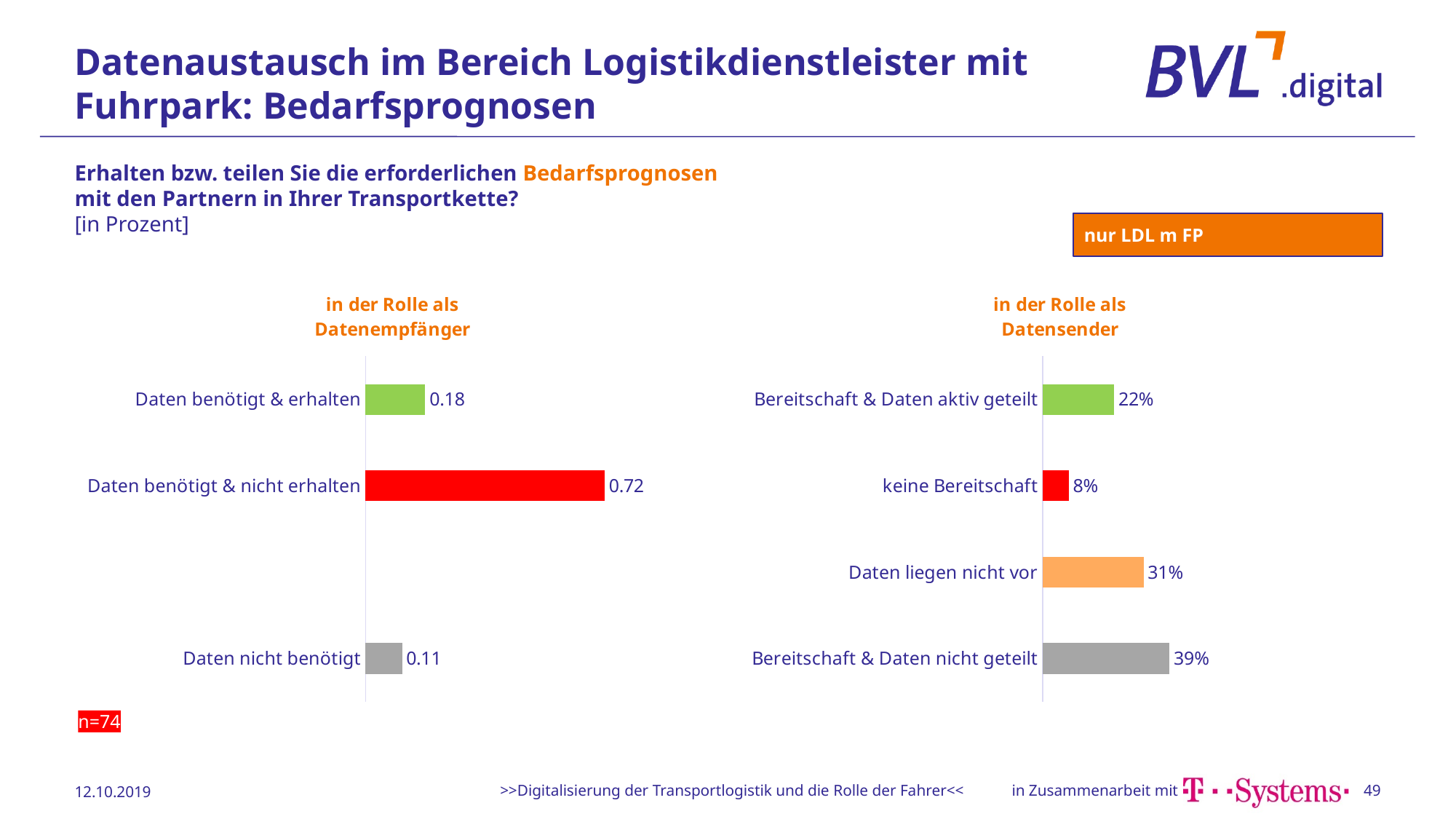
What type of chart is used on this slide? Bar chart In the right chart (in der Rolle als Datensender), which is larger: "Daten liegen nicht vor" or "Bereitschaft & Daten aktiv geteilt"? Daten liegen nicht vor In the right chart (in der Rolle als Datensender), what is the value for "keine Bereitschaft"? 8% In the right chart (in der Rolle als Datensender), what is the value for "Daten liegen nicht vor"? 31% In the right chart (in der Rolle als Datensender), which category has the lowest value? keine Bereitschaft In the right chart (in der Rolle als Datensender), which category has the highest value? Bereitschaft & Daten nicht geteilt In the right chart (in der Rolle als Datensender), what is the difference between "Bereitschaft & Daten nicht geteilt" and "Bereitschaft & Daten aktiv geteilt"? 17% In the left chart (in der Rolle als Datenempfänger), what is the difference between "Daten benötigt & nicht erhalten" and "Daten benötigt & erhalten"? 0.54 In the left chart (in der Rolle als Datenempfänger), what is the value for "Daten benötigt & nicht erhalten"? 0.72 In the left chart (in der Rolle als Datenempfänger), which category has the highest value? Daten benötigt & nicht erhalten In the left chart (in der Rolle als Datenempfänger), what is the value for "Daten nicht benötigt"? 0.11 How many categories does the right chart (in der Rolle als Datensender) show? 4